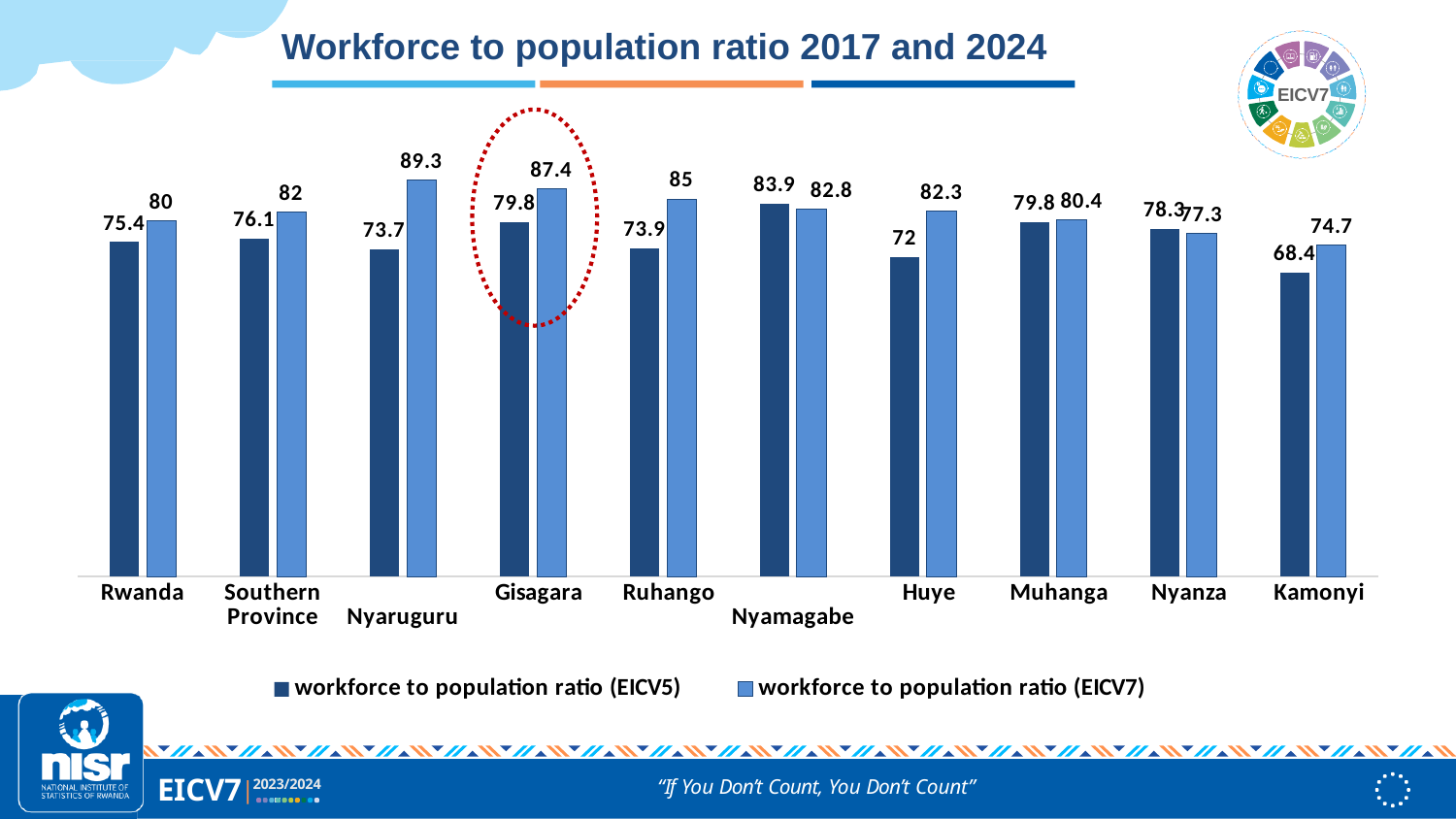
What type of chart is shown on the slide? Bar chart For Nyamagabe, which is larger: the EICV5 or the EICV7 workforce to population ratio? EICV5 What is the workforce to population ratio (EICV7) for Rwanda? 80 What is the workforce to population ratio (EICV7) for Nyaruguru? 89.3 Which district or region has the highest workforce to population ratio (EICV5)? Nyamagabe What is the workforce to population ratio (EICV5) for Huye? 72 Which district or region has the highest workforce to population ratio (EICV7)? Nyaruguru What is the difference between the EICV7 and EICV5 workforce to population ratios for Gisagara? 7.6 How many categories (regions/districts) are shown on the x axis? 10 How many series does the legend list? 2 What is the difference between the EICV7 and EICV5 workforce to population ratios for Nyaruguru? 15.6 Which district or region has the lowest workforce to population ratio (EICV5)? Kamonyi